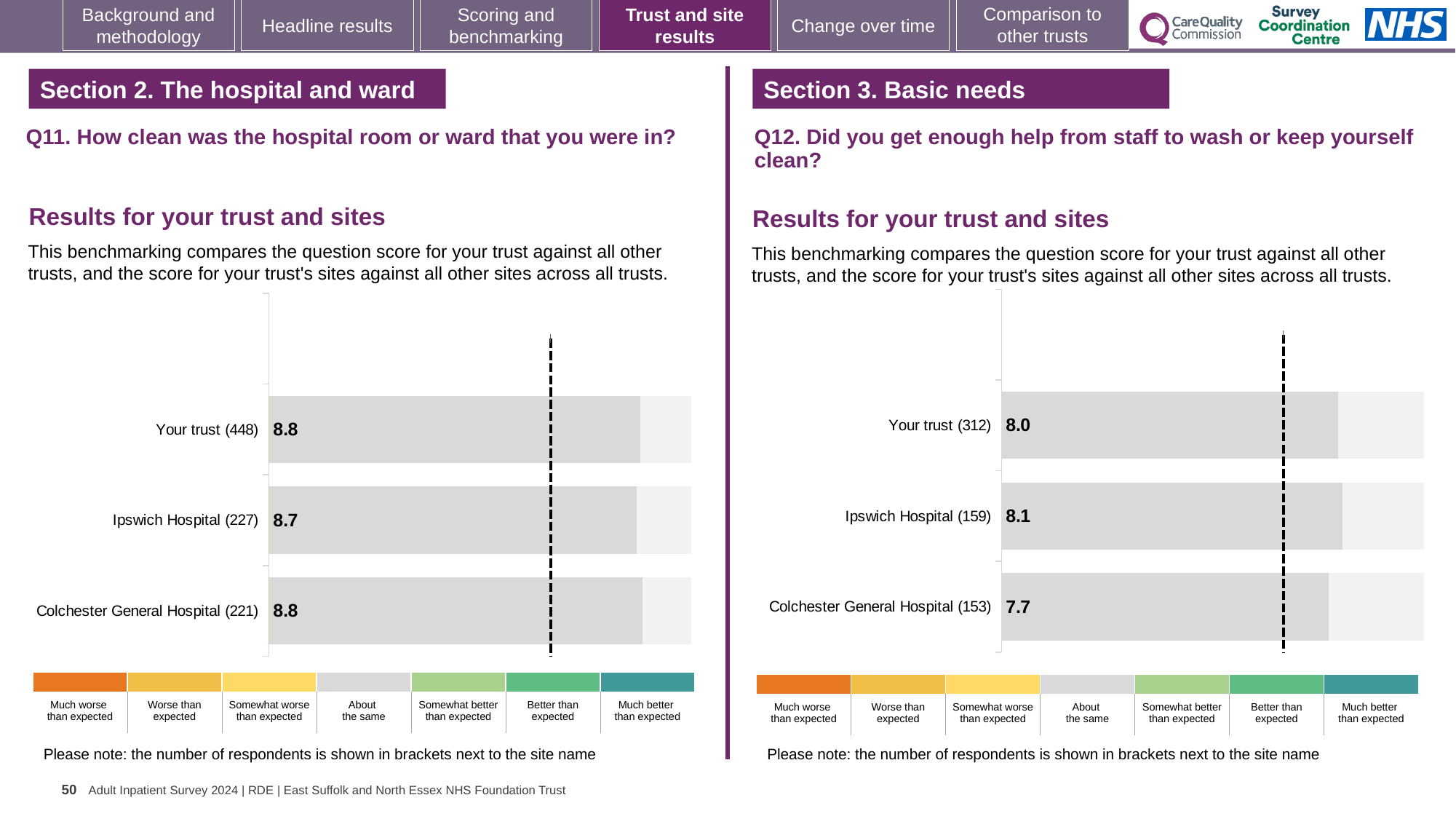
What kind of chart is used for the Q12 results on the right? Bar chart In the Q12 chart on the right, what is the score for Your trust? 8.0 In the Q12 chart on the right, which site or trust has the highest score? Ipswich Hospital In the Q11 chart on the left, which has the lowest score? Ipswich Hospital In the Q11 chart on the left, how many respondents are shown in brackets for Your trust? 448 In the Q12 chart on the right, what is the score for Colchester General Hospital? 7.7 In the Q11 chart on the left, what is the score for Your trust? 8.8 In the Q12 chart on the right, which site or trust has the lowest score? Colchester General Hospital In the Q12 chart on the right, which has the larger score, Your trust or Colchester General Hospital? Your trust How many bars are shown in the Q11 chart on the left? 3 In the Q11 chart on the left, what is the score for Ipswich Hospital? 8.7 In the Q12 chart on the right, what is the difference between the scores for Ipswich Hospital and Colchester General Hospital? 0.4